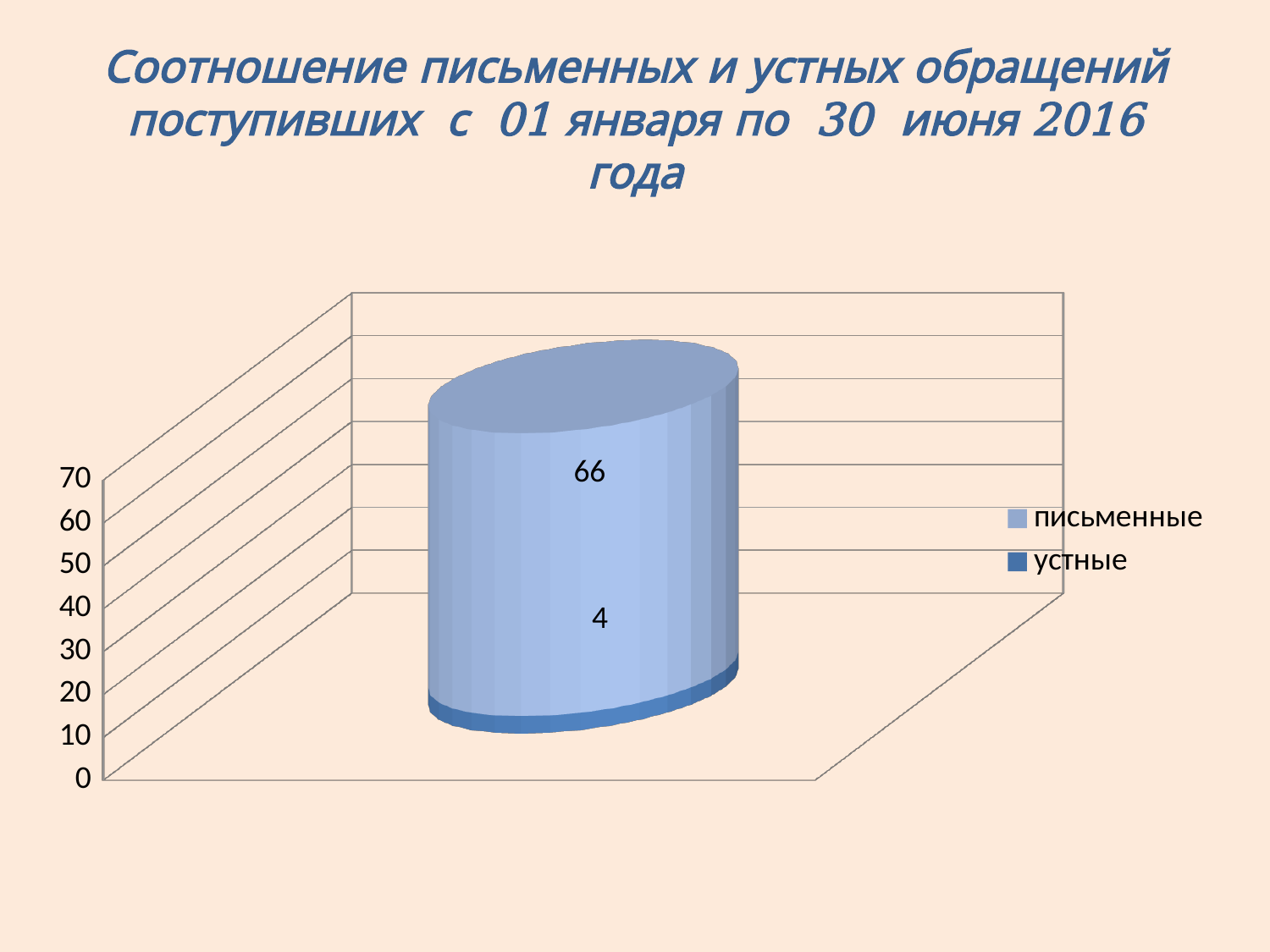
Which series has the larger value, письменные or устные? письменные What is the value for письменные? 66 Which series has the smallest value? устные What is the total of the stacked bar? 70 Which series has the largest value? письменные What is the highest value shown on the vertical axis? 70 What is the value for устные? 4 Is the value for письменные greater or less than 50? greater What kind of chart is shown on the slide? bar chart Is the value for устные greater or less than 10? less What is the difference between the values for письменные and устные? 62 How many series does the legend list? 2